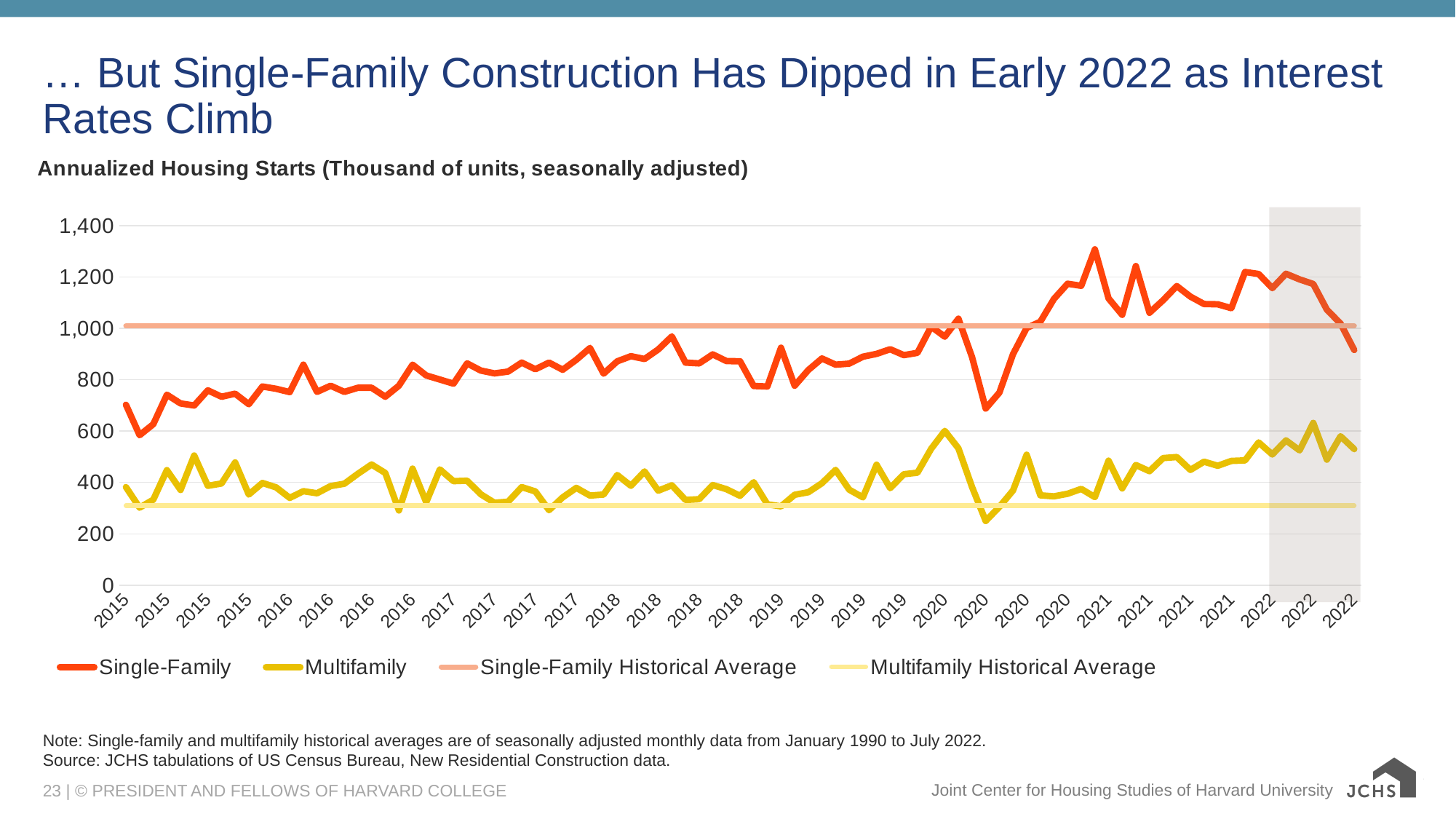
Is the highest point of the Single-Family line greater or less than 1,200? greater Which series has the highest values throughout the chart, Single-Family or Multifamily? Single-Family Which is larger in 2022, the Single-Family line or the Multifamily line? Single-Family Is the Multifamily Historical Average line greater or less than 200? greater Is the lowest point of the Multifamily line greater or less than 400? less How many series does the legend list? 4 What is the title of the chart? Annualized Housing Starts (Thousand of units, seasonally adjusted) Does the Single-Family line rise or fall across the shaded 2022 region at the right of the chart? fall What kind of chart is shown on the slide? line chart